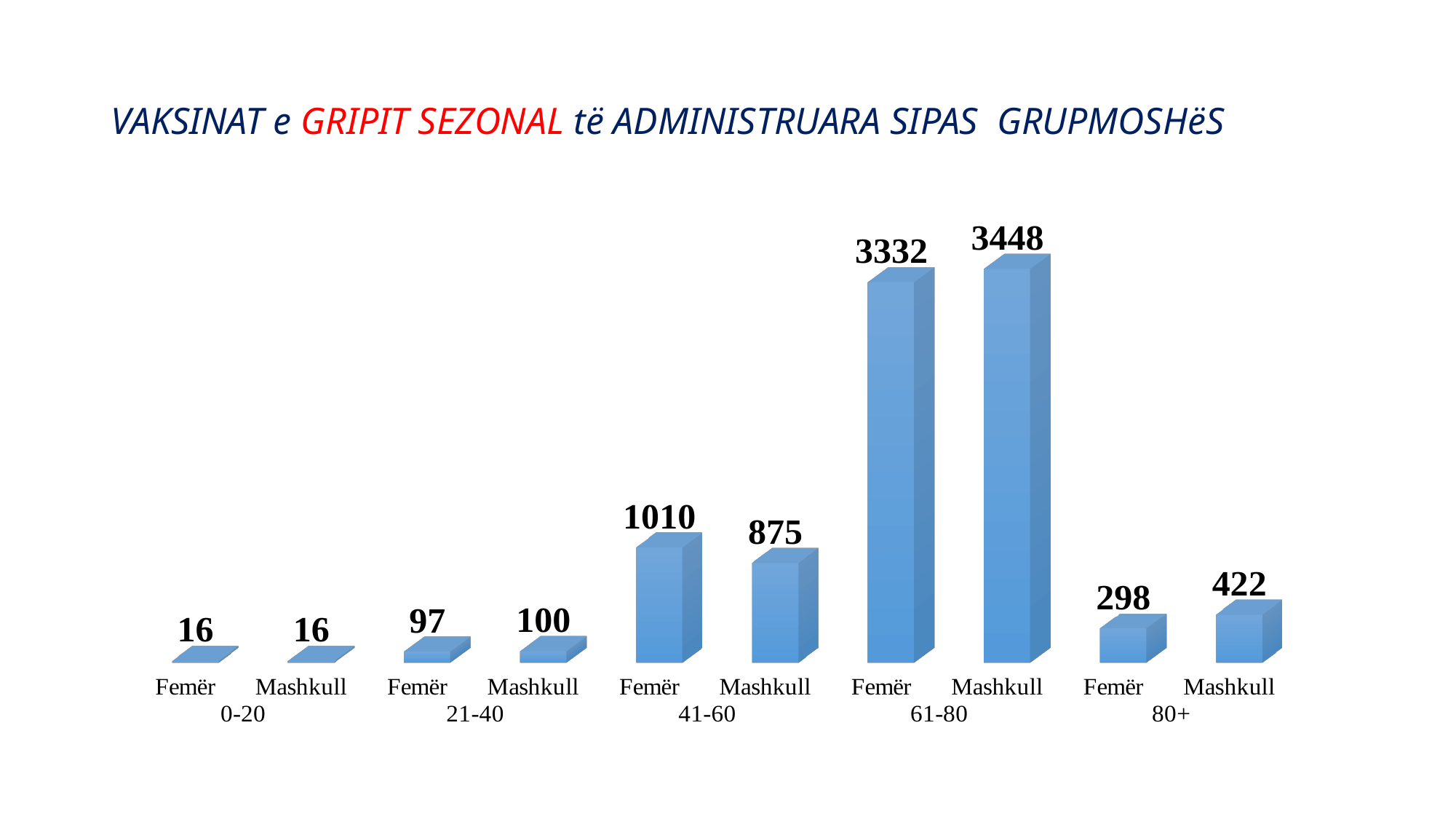
In the 80+ age group, which is larger, Femër or Mashkull? Mashkull What kind of chart is shown on the slide? Bar chart How many age groups are shown on the x axis? 5 What is the value for Femër in the 41-60 age group? 1010 How many bars are plotted on the chart? 10 What is the difference between the Mashkull and Femër values in the 61-80 age group? 116 What is the difference between the Femër and Mashkull values in the 41-60 age group? 135 What is the value for Mashkull in the 21-40 age group? 100 What is the value for Femër in the 80+ age group? 298 What is the value for Femër in the 0-20 age group? 16 Which bar has the highest value? Mashkull, 61-80 What is the value for Mashkull in the 61-80 age group? 3448